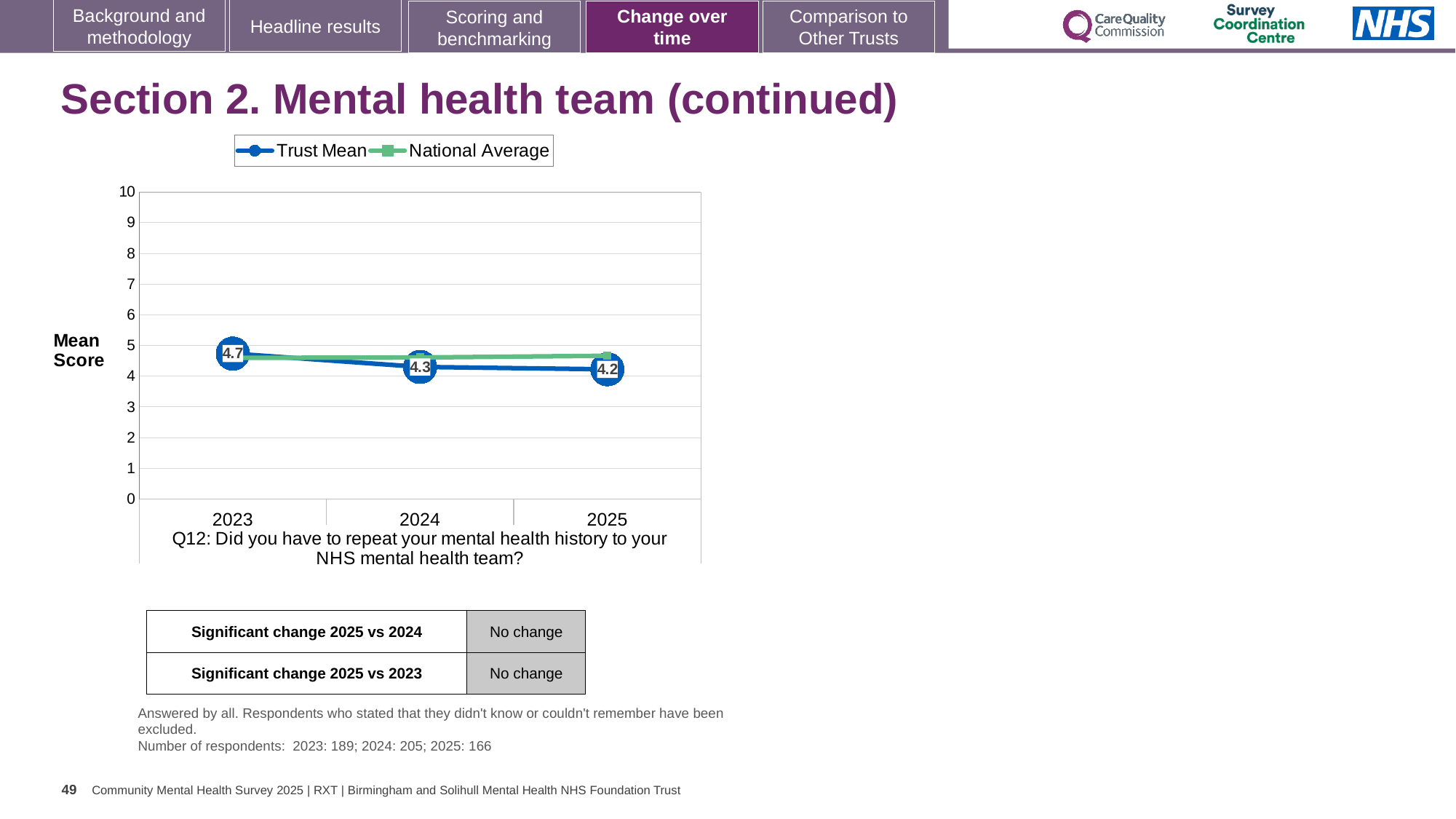
Is the National Average value for 2024 greater or less than 5? less Is the National Average value for 2025 greater or less than 4? greater What is the Trust Mean score for 2024? 4.3 How many series does the chart legend list? 2 What is the Trust Mean score for 2023? 4.7 Which is larger, the Trust Mean score in 2023 or in 2025? 2023 In which year is the Trust Mean score highest? 2023 What is the difference between the Trust Mean score in 2023 and in 2025? 0.5 What is the Trust Mean score for 2025? 4.2 In which year is the Trust Mean score lowest? 2025 Does the Trust Mean score rise or fall from 2023 to 2025? fall How many years are shown on the x axis of the chart? 3